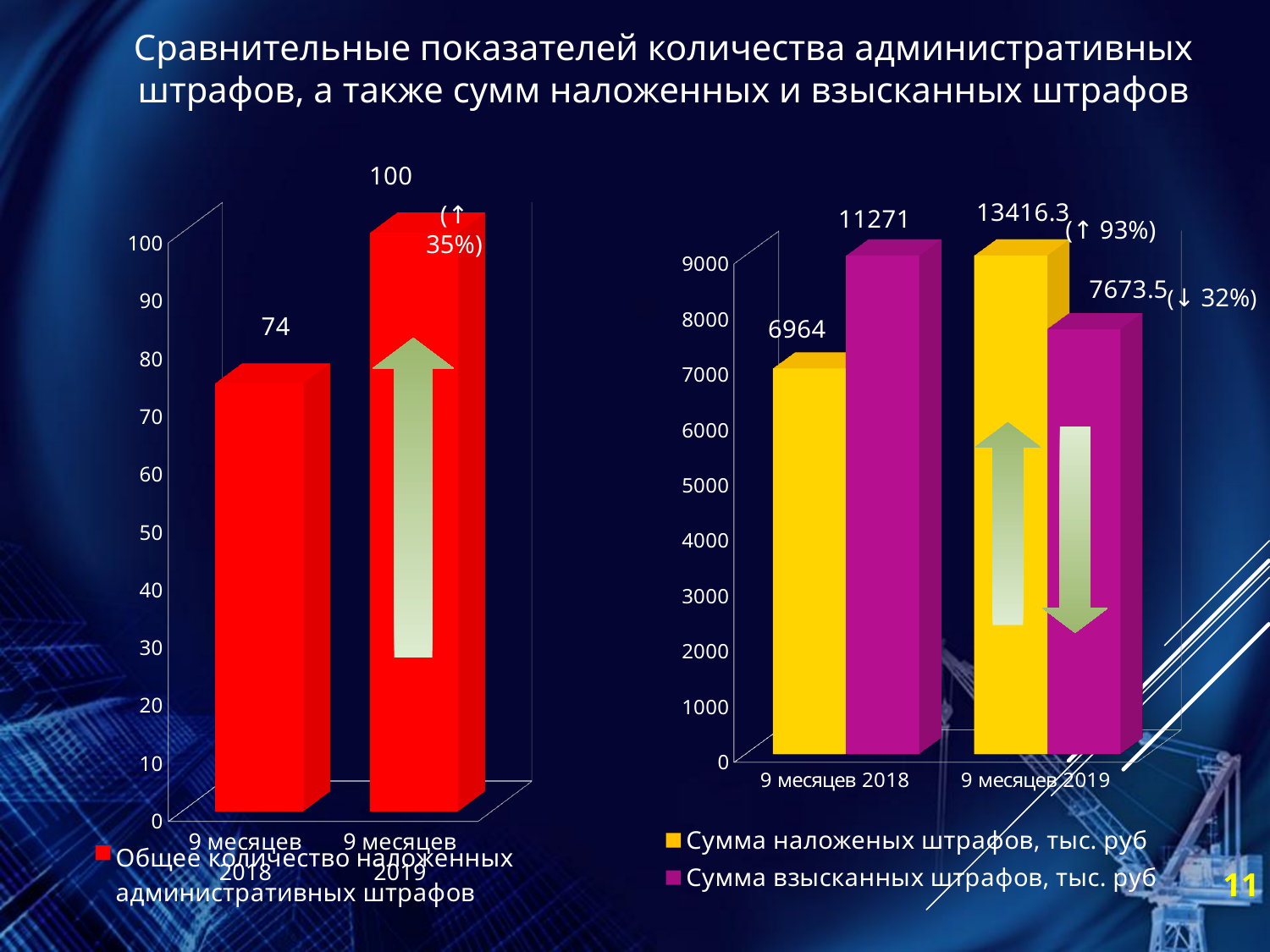
In the left chart, how many categories are shown on the x axis? 2 In the left chart, what is the difference between the values for 9 месяцев 2019 and 9 месяцев 2018? 26 In the left chart, what is the value for 9 месяцев 2019? 100 What kind of chart is the right chart? Bar chart In the right chart, what is the value of Сумма наложеных штрафов, тыс. руб for 9 месяцев 2018? 6964 In the right chart, what is the value of Сумма наложеных штрафов, тыс. руб for 9 месяцев 2019? 13416.3 In the left chart, what is the value for 9 месяцев 2018? 74 In the left chart, what percentage change is annotated next to the 2019 bar? ↑ 35% In the right chart, what is the value of Сумма взысканных штрафов, тыс. руб for 9 месяцев 2018? 11271 In the right chart, which is larger for 9 месяцев 2019: Сумма наложеных штрафов or Сумма взысканных штрафов? Сумма наложеных штрафов In the right chart, how many series does the legend list? 2 In the right chart, what is the value of Сумма взысканных штрафов, тыс. руб for 9 месяцев 2019? 7673.5